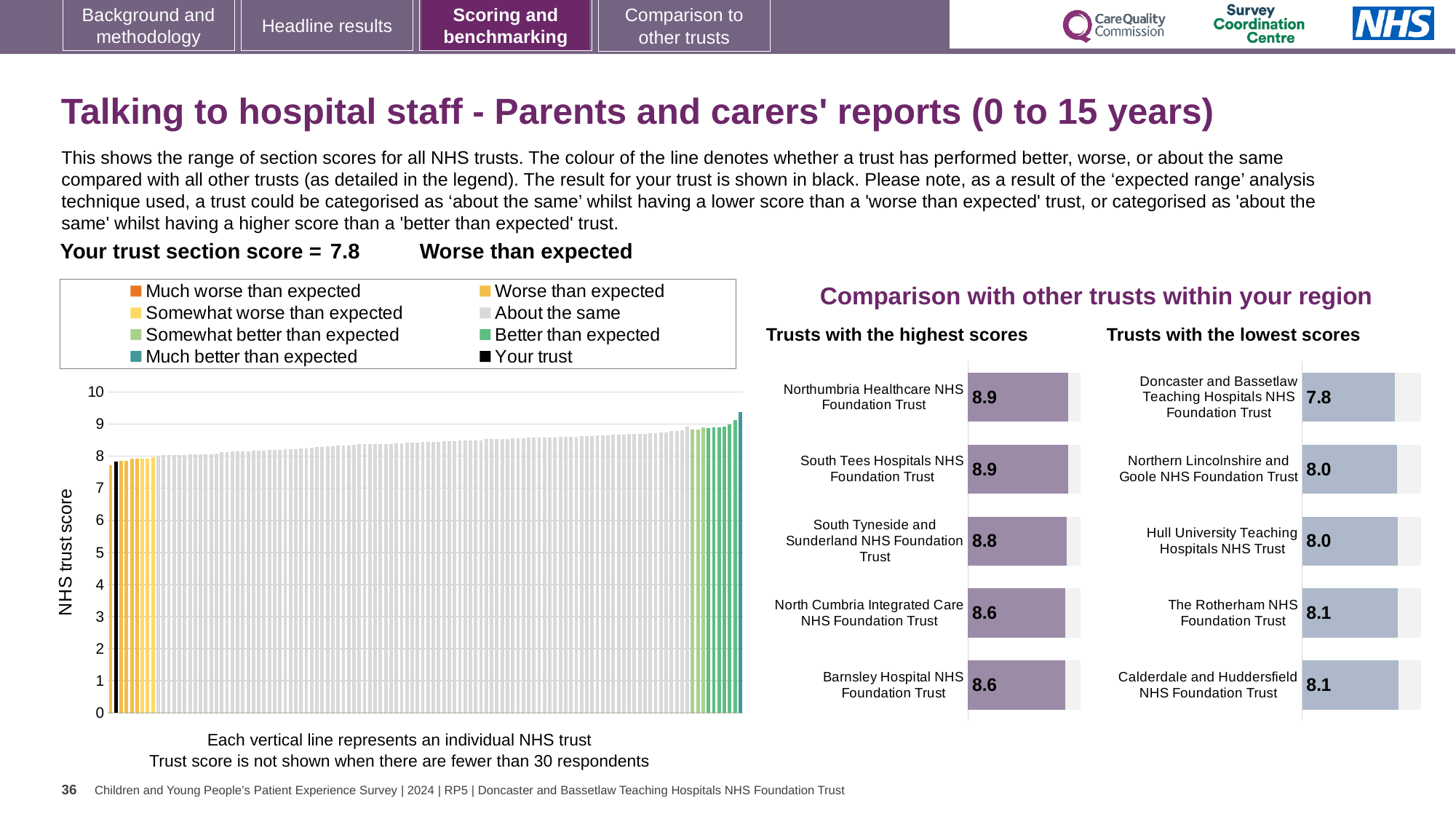
How many trusts are listed in the 'Trusts with the lowest scores' chart? 5 In the 'Trusts with the highest scores' chart, what is the score for South Tyneside and Sunderland NHS Foundation Trust? 8.8 What kind of chart is the large chart on the left showing the range of section scores for all NHS trusts? Bar chart In the 'Trusts with the highest scores' chart, what is the difference between the scores of Northumbria Healthcare NHS Foundation Trust and Barnsley Hospital NHS Foundation Trust? 0.3 How many entries does the legend above the large chart on the left list? 8 In the 'Trusts with the lowest scores' chart, what is the score for The Rotherham NHS Foundation Trust? 8.1 In the 'Trusts with the lowest scores' chart, which trust has the lowest score? Doncaster and Bassetlaw Teaching Hospitals NHS Foundation Trust In the large chart on the left, is the value of the tallest bar greater or less than 9? greater In the 'Trusts with the highest scores' chart, which has the higher score: South Tyneside and Sunderland NHS Foundation Trust or Barnsley Hospital NHS Foundation Trust? South Tyneside and Sunderland NHS Foundation Trust What is the y-axis label of the large chart on the left? NHS trust score In the 'Trusts with the lowest scores' chart, what is the difference between the scores of Calderdale and Huddersfield NHS Foundation Trust and Doncaster and Bassetlaw Teaching Hospitals NHS Foundation Trust? 0.3 In the 'Trusts with the highest scores' chart, what is the score for North Cumbria Integrated Care NHS Foundation Trust? 8.6